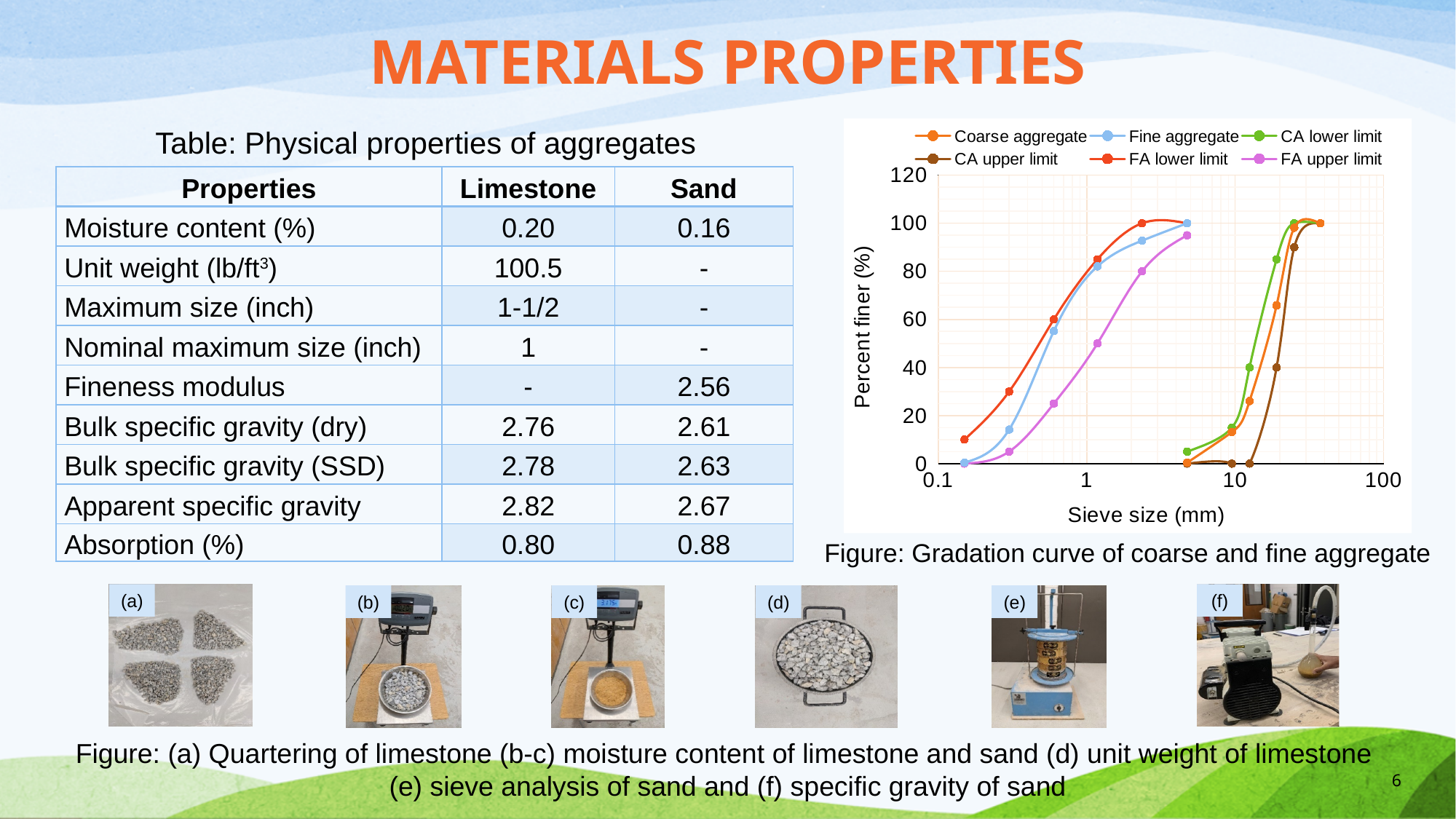
In the gradation curve chart, at a sieve size of 1 mm, which is higher: FA lower limit or FA upper limit? FA lower limit In the gradation curve chart, is the CA upper limit value at a sieve size of 10 mm greater or less than 20? less What kind of chart is the gradation curve figure? line chart In the gradation curve chart, do the curves rise or fall as sieve size increases? rise In the gradation curve chart, which series reaches 100 percent finer at the smallest sieve size? FA lower limit In the gradation curve chart, at a sieve size of 10 mm, which is higher: CA lower limit or CA upper limit? CA lower limit What is the label of the x axis of the gradation curve chart? Sieve size (mm) How many series does the legend of the gradation curve chart list? 6 In the gradation curve chart, is the Fine aggregate value at a sieve size of 1 mm greater or less than 60? greater What is the label of the y axis of the gradation curve chart? Percent finer (%) In the gradation curve chart, is the Coarse aggregate value at a sieve size of 10 mm greater or less than 20? less